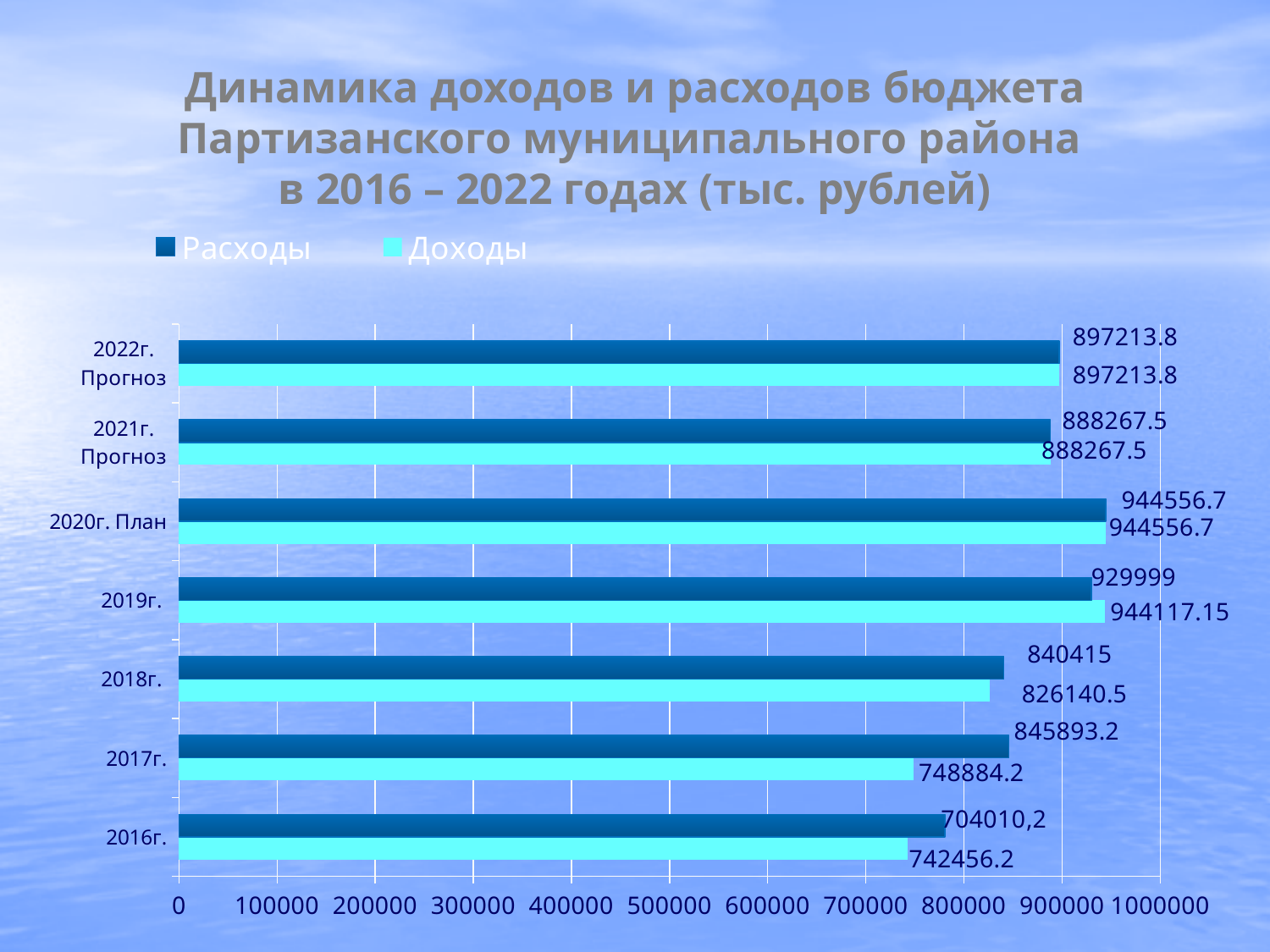
How many categories are shown on the y axis? 7 What is the difference between Доходы and Расходы for 2019г.? 14118.15 Is the value of Доходы for 2017г. greater or less than 800000? less What is the value of Доходы for 2019г.? 944117.15 What is the value of Расходы for 2022г. Прогноз? 897213.8 Which category has the highest value for Расходы? 2020г. План How many series does the legend list? 2 What is the value of Расходы for 2018г.? 840415 What is the value of Доходы for 2017г.? 748884.2 For 2018г., which is larger: Расходы or Доходы? Расходы What kind of chart is shown on the slide? bar chart What is the difference between Расходы and Доходы for 2017г.? 97009